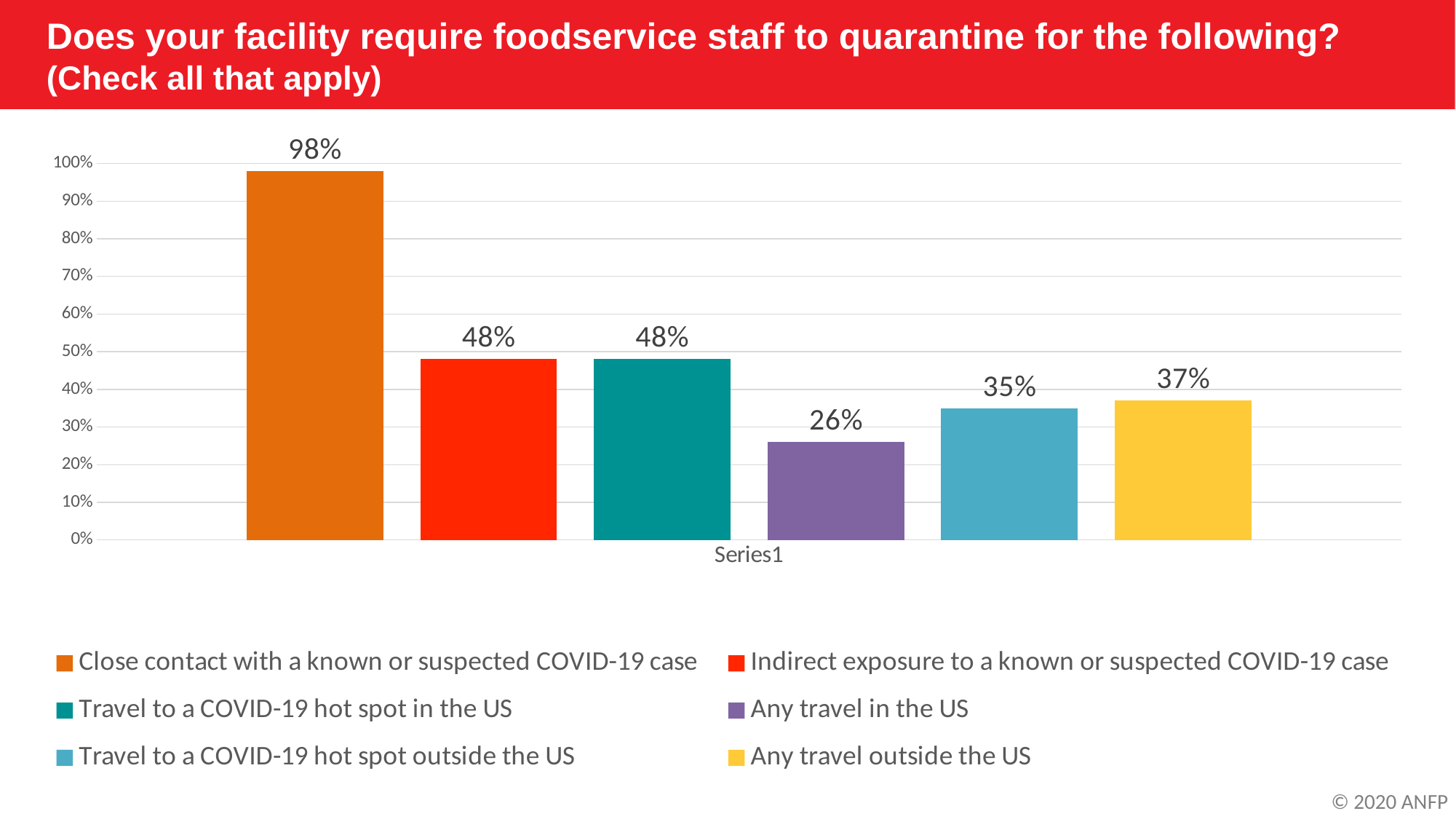
What percentage of facilities require quarantine for travel to a COVID-19 hot spot outside the US? 35% What kind of chart is shown on the slide? Bar chart Which is larger: the value for any travel outside the US or the value for travel to a COVID-19 hot spot outside the US? Any travel outside the US How many categories are shown in the chart? 6 Which category has the highest value? Close contact with a known or suspected COVID-19 case What percentage of facilities require quarantine for any travel outside the US? 37% What is the difference between the value for close contact with a known or suspected COVID-19 case and the value for indirect exposure to a known or suspected COVID-19 case? 50% What is the difference between the value for any travel outside the US and the value for any travel in the US? 11% Which category has the lowest value? Any travel in the US What percentage of facilities require quarantine for close contact with a known or suspected COVID-19 case? 98% What percentage of facilities require quarantine for any travel in the US? 26% What colour is the bar for travel to a COVID-19 hot spot in the US? Teal